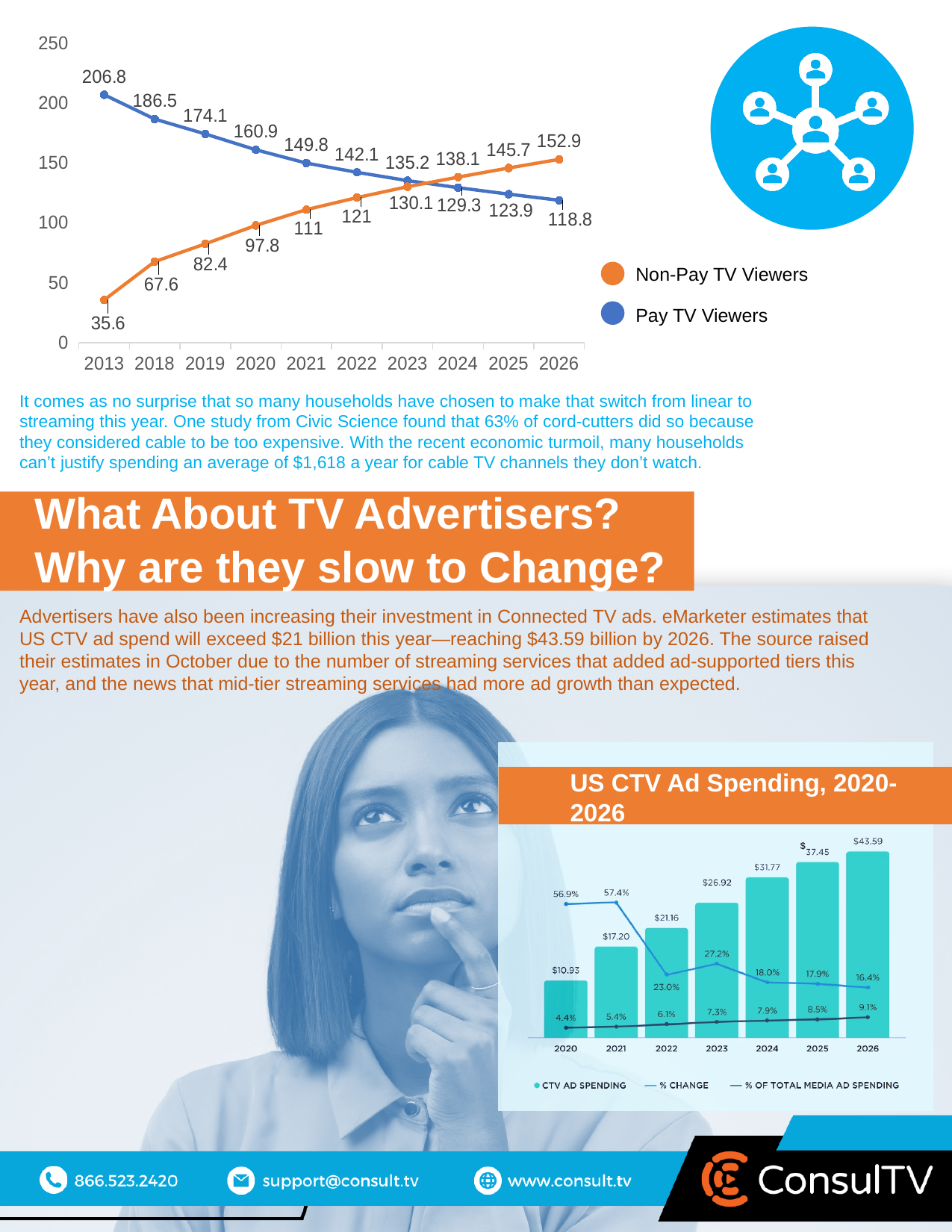
In the top line chart, which series has the larger value in 2025, Pay TV Viewers or Non-Pay TV Viewers? Non-Pay TV Viewers In the top line chart, how does the Pay TV Viewers series change from 2013 to 2026? It falls In the 'US CTV Ad Spending, 2020-2026' chart, what is the % of total media ad spending in 2026? 9.1% In the 'US CTV Ad Spending, 2020-2026' chart, which year has the highest CTV ad spending? 2026 In the top line chart, what is the value for Non-Pay TV Viewers in 2026? 152.9 In the 'US CTV Ad Spending, 2020-2026' chart, what is the CTV ad spending value for 2023? $26.92 How many series does the legend of the top line chart list? 2 In the 'US CTV Ad Spending, 2020-2026' chart, what is the % change value for 2022? 23.0% In the top line chart, what is the difference between Pay TV Viewers and Non-Pay TV Viewers in 2020? 63.1 In the top line chart, what is the value for Pay TV Viewers in 2013? 206.8 How many years are shown on the x axis of the top line chart? 10 In the 'US CTV Ad Spending, 2020-2026' chart, what is the difference in CTV ad spending between 2026 and 2020? $32.66